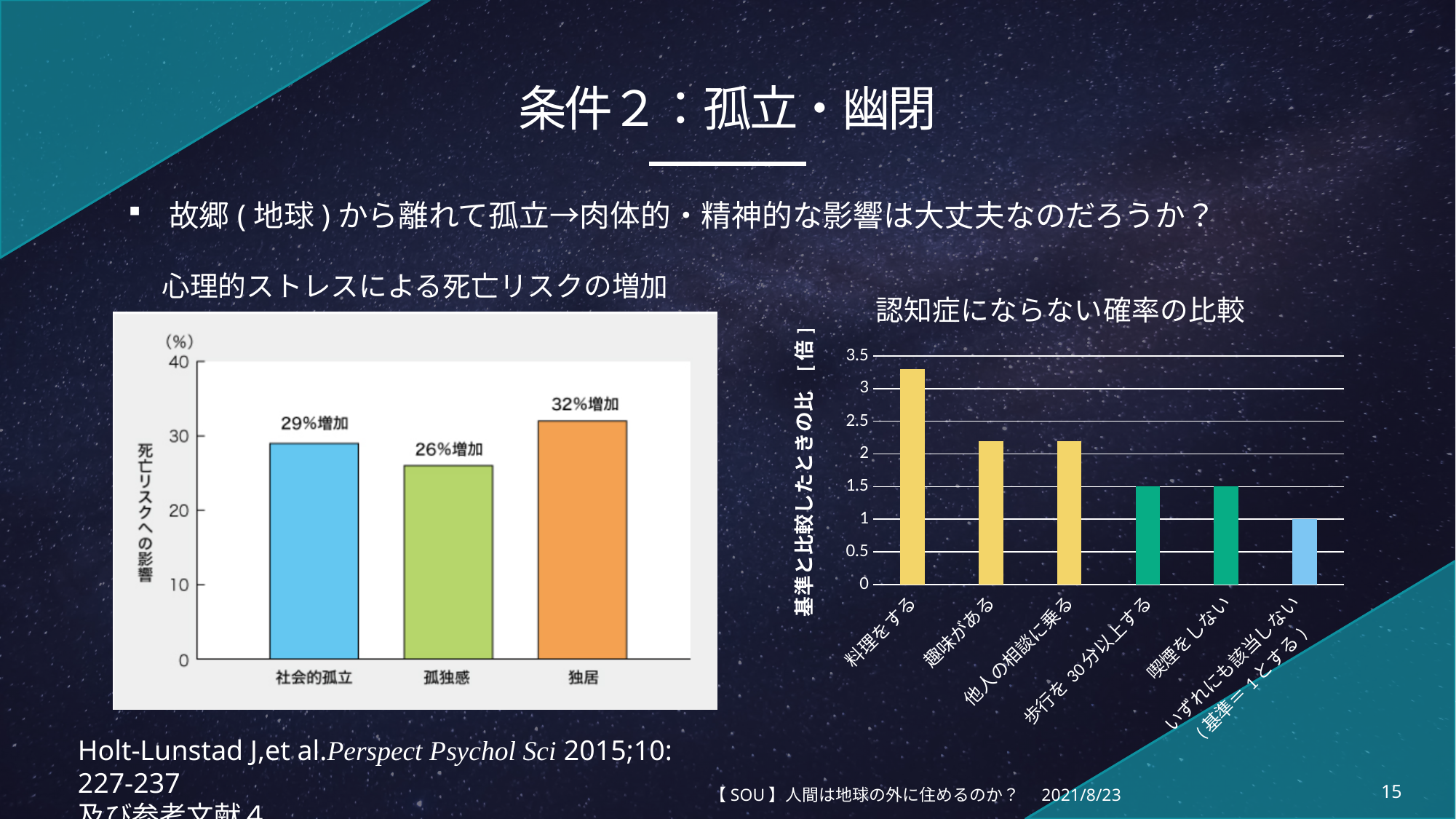
What kind of chart is the right chart (認知症にならない確率の比較)? bar chart On the right chart (認知症にならない確率の比較), what is the value for いずれにも該当しない? 1 On the right chart (認知症にならない確率の比較), which category has the highest value? 料理をする On the right chart (認知症にならない確率の比較), how many categories are shown? 6 On the left chart (心理的ストレスによる死亡リスクの増加), what is the difference between the values for 独居 and 孤独感? 6% On the left chart (心理的ストレスによる死亡リスクの増加), which category has the lowest value? 孤独感 On the left chart (心理的ストレスによる死亡リスクの増加), which category has the highest value? 独居 On the right chart (認知症にならない確率の比較), what is the value for 歩行を30分以上する? 1.5 On the left chart (心理的ストレスによる死亡リスクの増加), how many categories are shown? 3 On the left chart (心理的ストレスによる死亡リスクの増加), what is the value shown for 独居? 32%増加 On the left chart (心理的ストレスによる死亡リスクの増加), what is the value shown for 社会的孤立? 29%増加 On the right chart (認知症にならない確率の比較), is the value for 料理をする greater or less than 3? greater